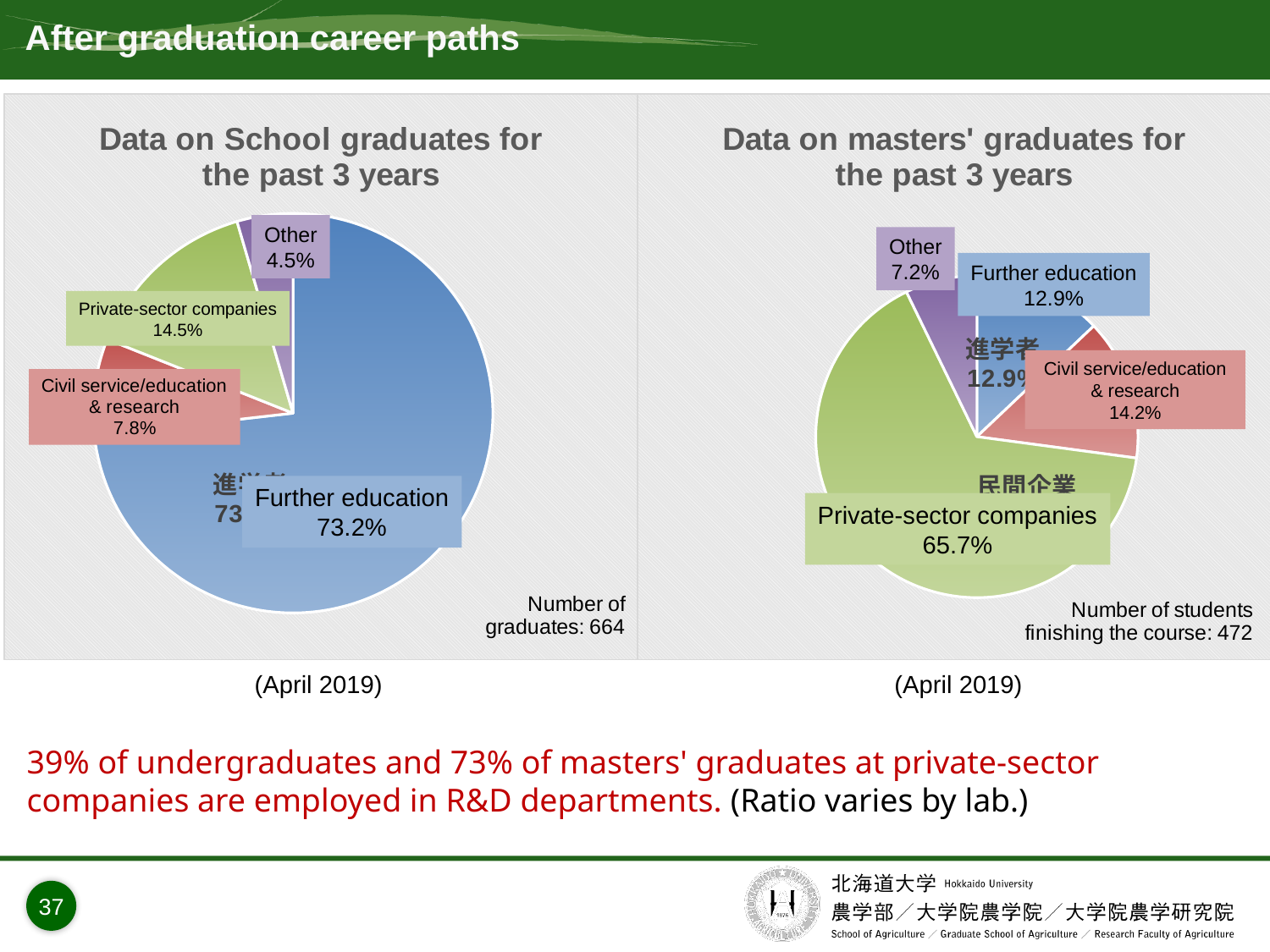
In the chart titled "Data on School graduates for the past 3 years", which category has the largest share? Further education In the chart titled "Data on masters' graduates for the past 3 years", which is larger: the Further education share or the Other share? Further education How many categories does the chart titled "Data on School graduates for the past 3 years" show? 4 In the chart titled "Data on masters' graduates for the past 3 years", what share went to private-sector companies? 65.7% In the chart titled "Data on School graduates for the past 3 years", what is the combined share of Other and Civil service/education & research? 12.3% In the chart titled "Data on School graduates for the past 3 years", what percentage went to private-sector companies? 14.5% What type of chart is used for the masters' graduates data on the right? Pie chart In the chart titled "Data on School graduates for the past 3 years", what share of graduates went on to further education? 73.2% In the chart titled "Data on masters' graduates for the past 3 years", which category has the smallest share? Other In the chart titled "Data on masters' graduates for the past 3 years", what percentage went into civil service/education & research? 14.2% In the chart titled "Data on School graduates for the past 3 years", what is the difference between the Private-sector companies share and the Civil service/education & research share? 6.7% According to the note on the right-hand chart, how many students finished the masters' course? 472